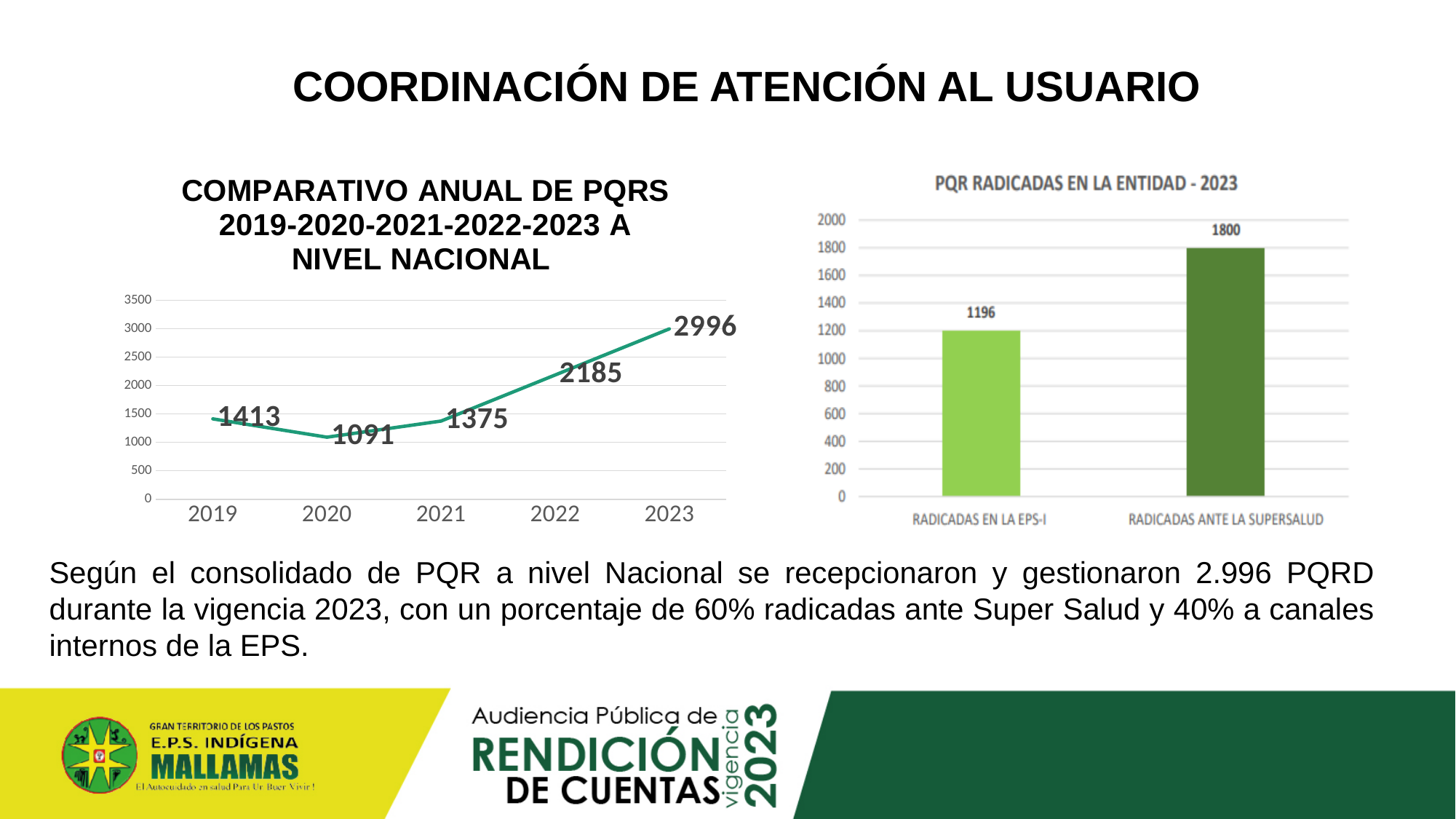
In the 'COMPARATIVO ANUAL DE PQRS' chart, do the values rise or fall from 2020 to 2023? rise What kind of chart is the 'PQR RADICADAS EN LA ENTIDAD - 2023' chart? bar chart In the 'COMPARATIVO ANUAL DE PQRS' chart, which is larger, the value for 2019 or the value for 2021? 2019 What kind of chart is the 'COMPARATIVO ANUAL DE PQRS' chart? line chart In the 'PQR RADICADAS EN LA ENTIDAD - 2023' chart, what is the value for RADICADAS ANTE LA SUPERSALUD? 1800 In the 'PQR RADICADAS EN LA ENTIDAD - 2023' chart, what is the difference between RADICADAS ANTE LA SUPERSALUD and RADICADAS EN LA EPS-I? 604 In the 'COMPARATIVO ANUAL DE PQRS' chart, what is the difference between the 2023 and 2022 values? 811 In the 'COMPARATIVO ANUAL DE PQRS' chart, which year has the lowest value? 2020 In the 'COMPARATIVO ANUAL DE PQRS' chart, what is the value for 2020? 1091 In the 'COMPARATIVO ANUAL DE PQRS' chart, which year has the highest value? 2023 In the 'COMPARATIVO ANUAL DE PQRS' chart, what is the value for 2023? 2996 In the 'COMPARATIVO ANUAL DE PQRS' chart, how many years are plotted? 5